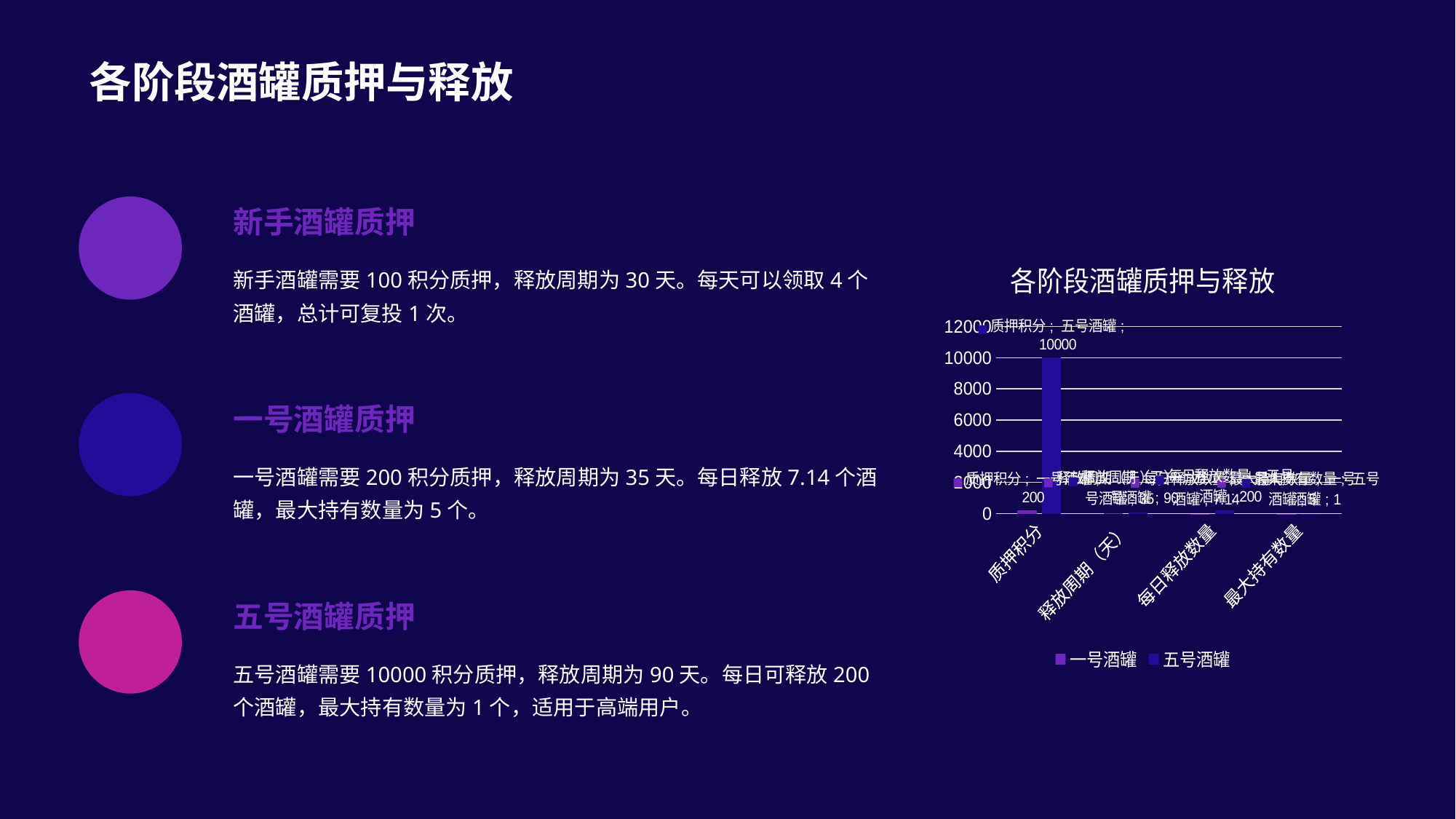
What is the 质押积分 value for 五号酒罐 in the chart? 10000 For 质押积分, which series has the larger value, 一号酒罐 or 五号酒罐? 五号酒罐 What kind of chart is shown on the slide? Bar chart Is the 质押积分 value for 五号酒罐 greater or less than 8000? greater Is the 质押积分 value for 一号酒罐 greater or less than 2000? less How many categories are shown on the x axis of the chart? 4 How many series does the chart legend list? 2 What is the 质押积分 value for 一号酒罐 in the chart? 200 What are the two series names listed in the chart legend? 一号酒罐 and 五号酒罐 What is the difference between the 质押积分 values of 五号酒罐 and 一号酒罐? 9800 What is the title of the chart? 各阶段酒罐质押与释放 Which category has the tallest bar in the chart? 质押积分